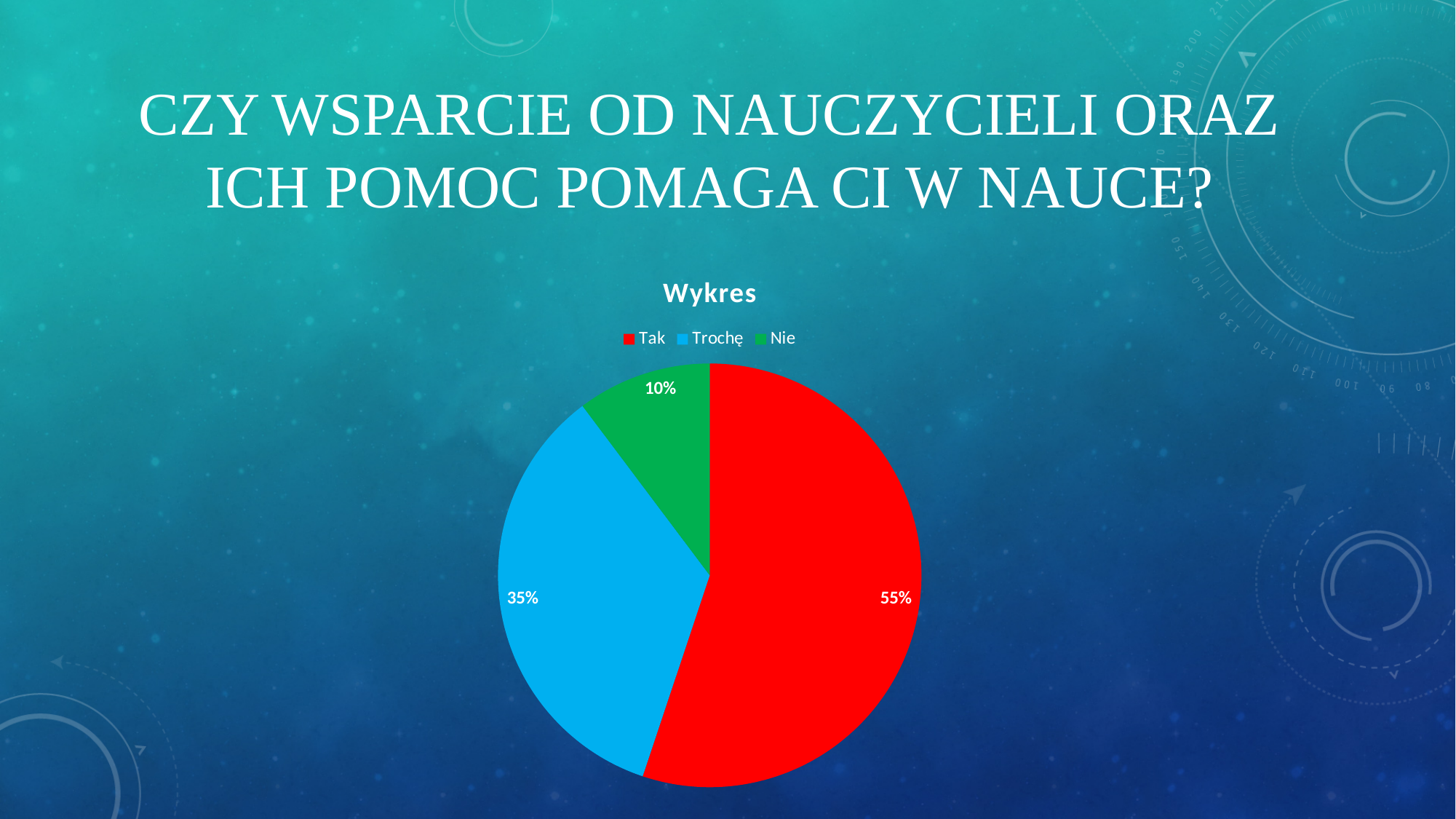
What share of the pie does the 'Tak' slice represent? 55% What is the difference in percentage points between the 'Trochę' and 'Nie' slices? 25% What share of the pie does the 'Nie' slice represent? 10% How many categories are shown in the pie chart? 3 What share of the pie does the 'Trochę' slice represent? 35% What is the difference in percentage points between the 'Tak' and 'Trochę' slices? 20% Which category has the largest slice of the pie? Tak What colour is the 'Nie' slice in the pie chart? Green Which category has the smallest slice of the pie? Nie What kind of chart is shown on the slide? Pie chart What is the title of the chart? Wykres Which is larger, the 'Trochę' slice or the 'Nie' slice? Trochę